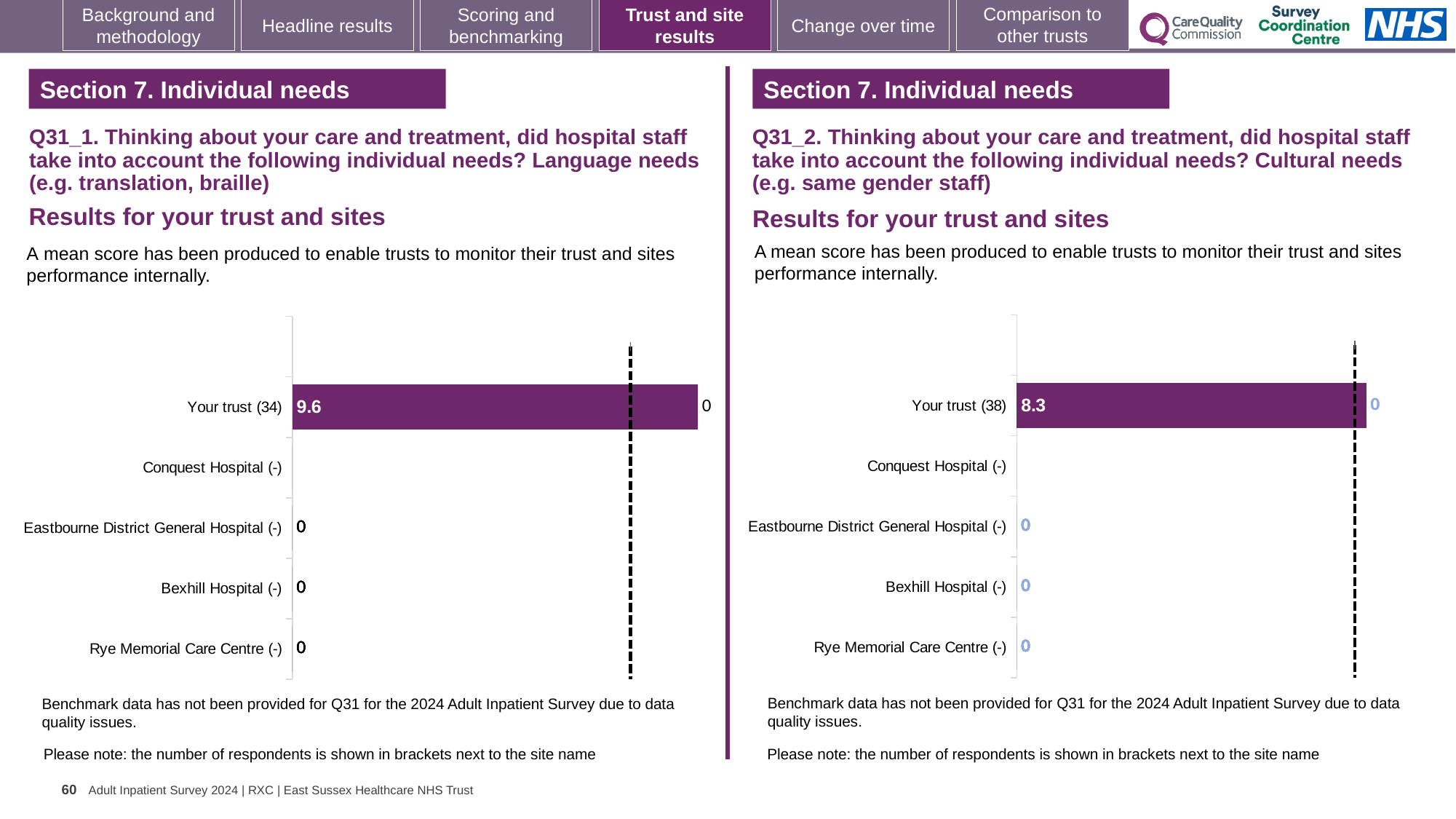
In the right chart (Q31_2, Cultural needs), how many respondents are shown in brackets next to Your trust? 38 What is the difference between the Your trust score in the left chart (Q31_1, 9.6) and the Your trust score in the right chart (Q31_2, 8.3)? 1.3 In the right chart (Q31_2, Cultural needs), which category has the highest value? Your trust (38) In the left chart (Q31_1, Language needs), what is the value shown for Bexhill Hospital? 0 How many categories are listed on the y axis of the left chart (Q31_1, Language needs)? 5 In the right chart (Q31_2, Cultural needs), what is the mean score for Your trust? 8.3 In the left chart (Q31_1, Language needs), how many respondents are shown in brackets next to Your trust? 34 Is the Your trust score in the left chart (Q31_1, Language needs) larger or smaller than the Your trust score in the right chart (Q31_2, Cultural needs)? Larger In the left chart (Q31_1, Language needs), which category has the highest value? Your trust (34) What kind of chart is the left chart (Q31_1, Language needs)? Bar chart How many categories are listed on the y axis of the right chart (Q31_2, Cultural needs)? 5 In the left chart (Q31_1, Language needs), what is the mean score for Your trust? 9.6